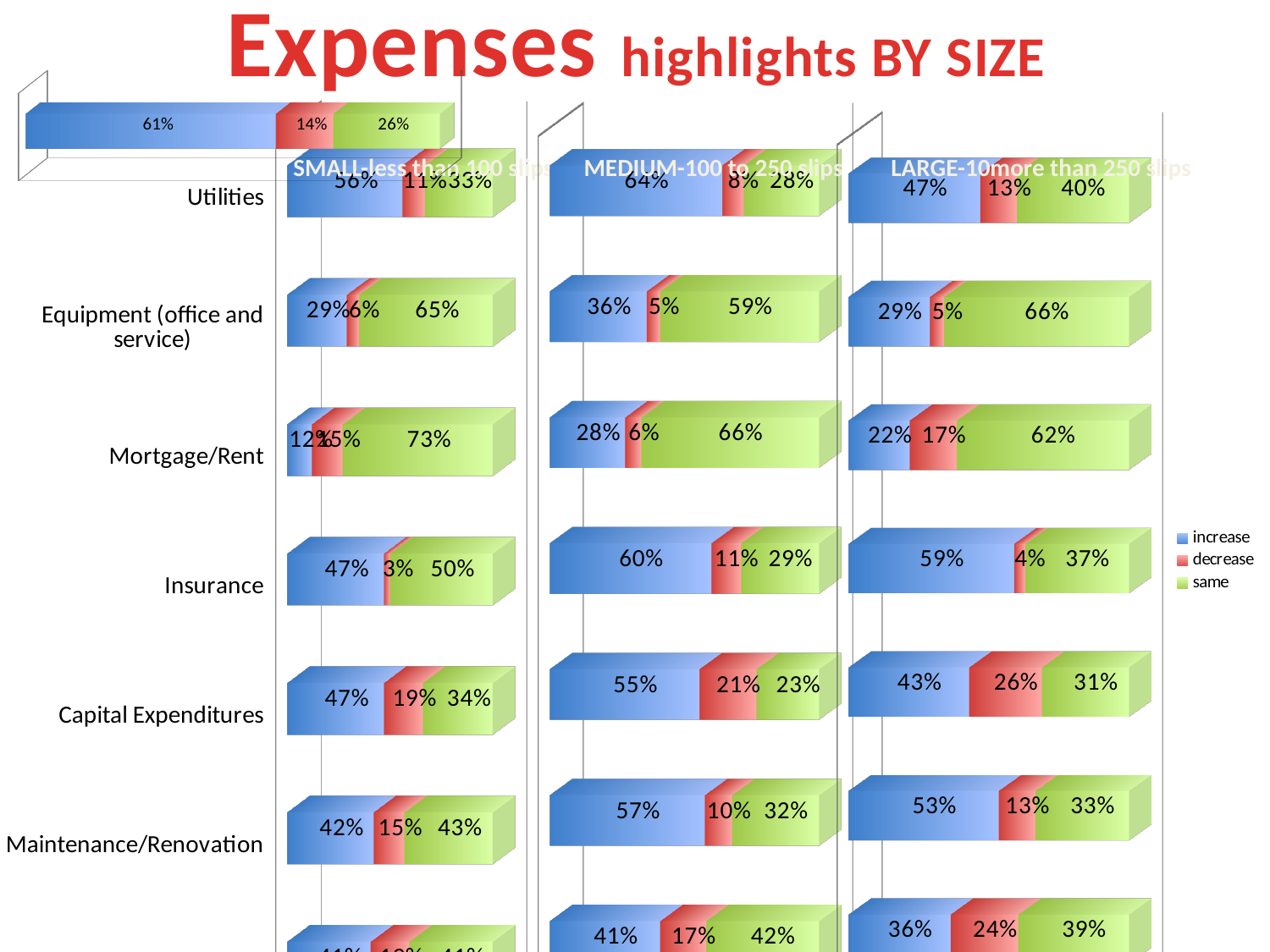
In the SMALL chart, for Insurance, which is larger: the 'increase' value or the 'same' value? same What are the three entries in the legend? increase, decrease, same In the LARGE chart, what is the 'same' value for Mortgage/Rent? 62% In the SMALL chart, what is the 'decrease' value for Capital Expenditures? 19% In the LARGE chart, which category has the lowest 'decrease' value? Insurance What kind of chart is used on this slide? Stacked bar chart In the MEDIUM chart, which category has the highest 'increase' value? Utilities In the LARGE chart, what is the difference between the 'increase' and 'same' values for Capital Expenditures? 12 percentage points In the MEDIUM chart, what percentage of respondents reported an increase for Insurance? 60% How many series does the legend list? 3 In the MEDIUM chart, what is the 'same' value for Equipment (office and service)? 59% Is the 'increase' value for Utilities larger in the MEDIUM chart or the LARGE chart? MEDIUM